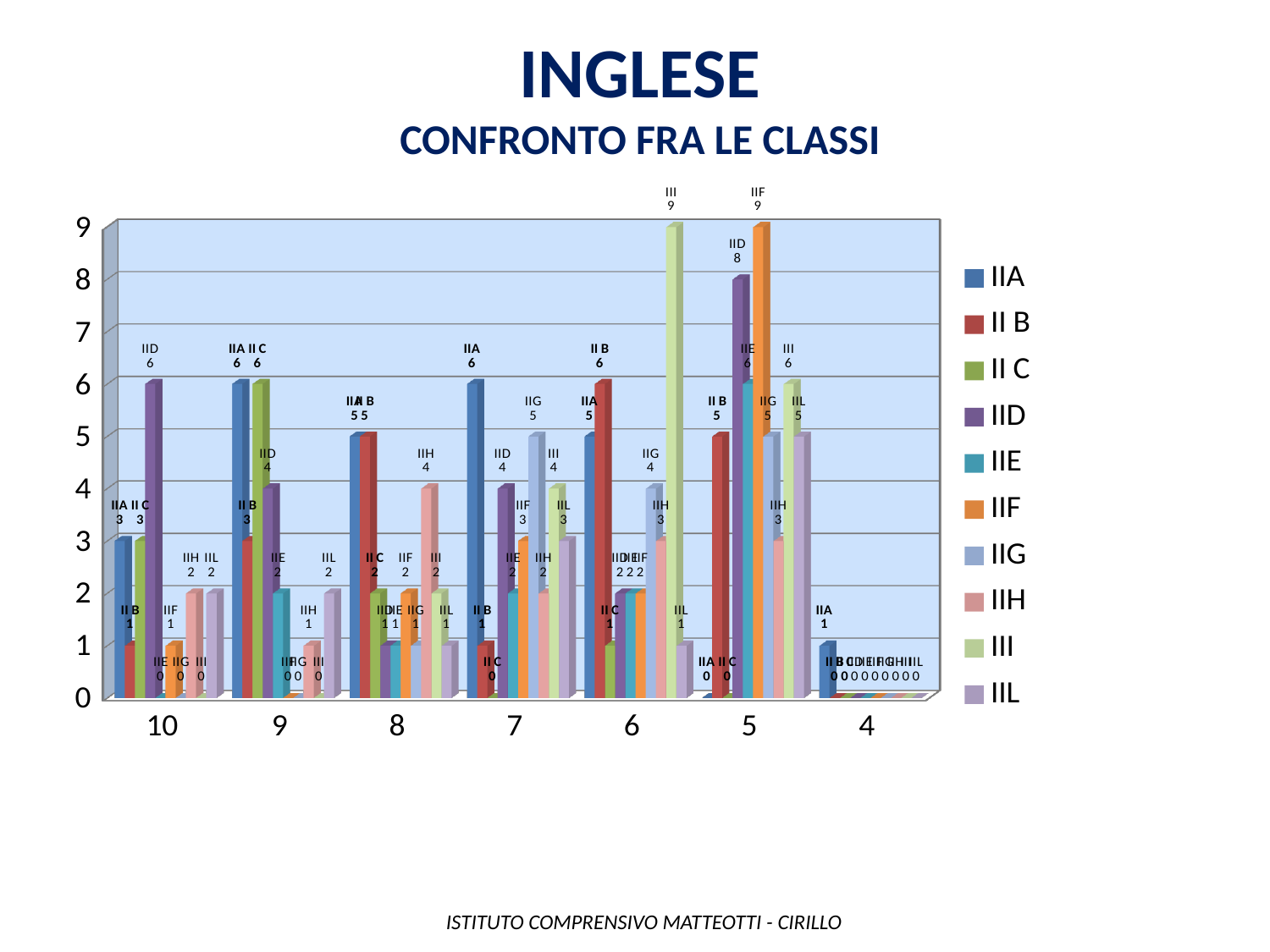
What is the value for IID at category 10? 6 What kind of chart is shown on the slide? bar chart What is the value for III at category 6? 9 At category 5, which series has the highest value? IIF How many series does the legend list? 10 Is the value for IIA larger at category 9 or at category 8? 9 What is the difference between the values for IID and IIH at category 5? 5 What is the value for IIF at category 5? 9 What is the value for IIG at category 7? 5 How many categories are shown on the x axis? 7 Is the value for IID at category 5 greater or less than 7? greater At category 4, which series has the highest value? IIA